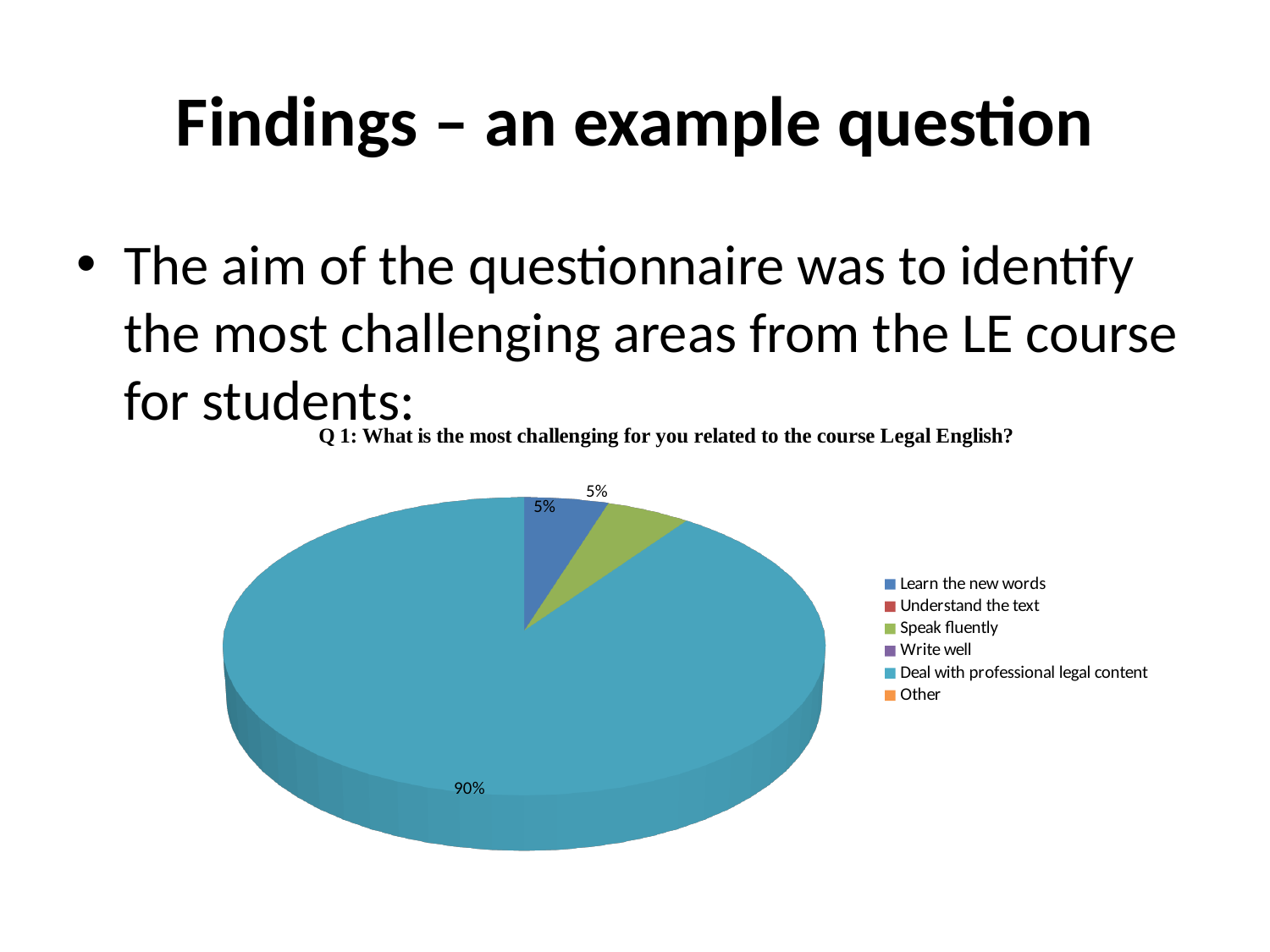
Which is larger, the share for 'Deal with professional legal content' or the share for 'Learn the new words'? Deal with professional legal content What share of the pie is 'Deal with professional legal content'? 90% What colour is the slice for 'Deal with professional legal content'? teal (blue-green) Which category has the largest share of the pie? Deal with professional legal content Is the share for 'Deal with professional legal content' greater or less than 50%? greater What kind of chart is shown on the slide? pie chart What is the title of the chart? Q 1: What is the most challenging for you related to the course Legal English? What share of the pie is 'Learn the new words'? 5% How many entries does the legend list? 6 What is the difference in percentage points between 'Deal with professional legal content' and 'Speak fluently'? 85 percentage points What share of the pie is 'Speak fluently'? 5% How many slices are visible in the pie? 3